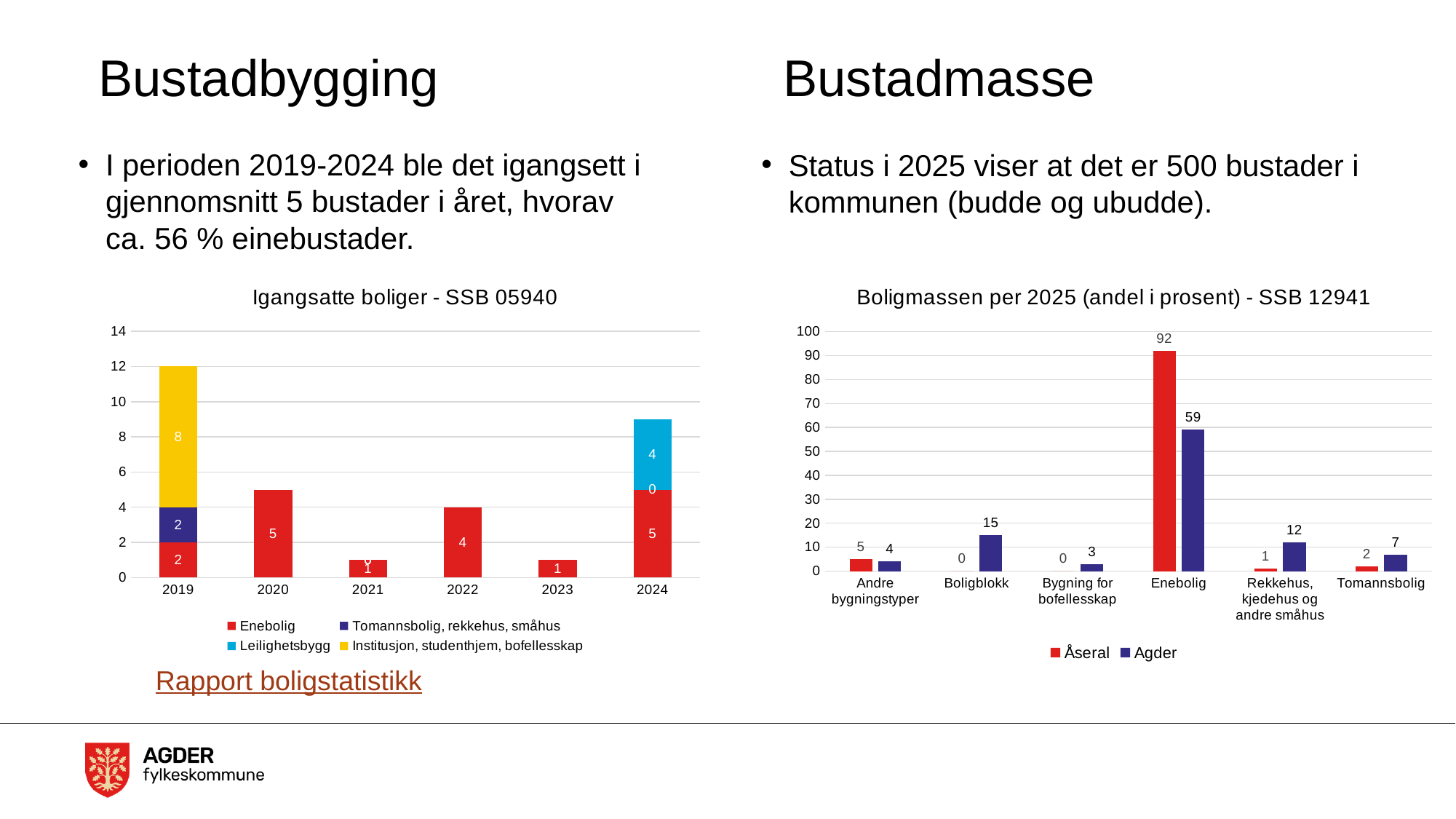
In the chart 'Igangsatte boliger - SSB 05940', what is the total of the stacked bar for 2019? 12 In the chart 'Igangsatte boliger - SSB 05940', what is the total of the stacked bar for 2024? 9 In the chart 'Boligmassen per 2025 (andel i prosent) - SSB 12941', what is the difference between Åseral and Agder for Enebolig? 33 In the chart 'Boligmassen per 2025 (andel i prosent) - SSB 12941', what is the value for Åseral for Enebolig? 92 What kind of chart is 'Boligmassen per 2025 (andel i prosent) - SSB 12941'? Bar chart In the chart 'Boligmassen per 2025 (andel i prosent) - SSB 12941', which is larger for Rekkehus, kjedehus og andre småhus: Åseral or Agder? Agder In the chart 'Igangsatte boliger - SSB 05940', how many years are shown on the x axis? 6 In the chart 'Igangsatte boliger - SSB 05940', how many series does the legend list? 4 In the chart 'Boligmassen per 2025 (andel i prosent) - SSB 12941', which category has the highest value for Agder? Enebolig In the chart 'Boligmassen per 2025 (andel i prosent) - SSB 12941', what is the value for Agder for Boligblokk? 15 In the chart 'Igangsatte boliger - SSB 05940', what is the value for Institusjon, studenthjem, bofellesskap in 2019? 8 In the chart 'Igangsatte boliger - SSB 05940', what is the value for Enebolig in 2020? 5